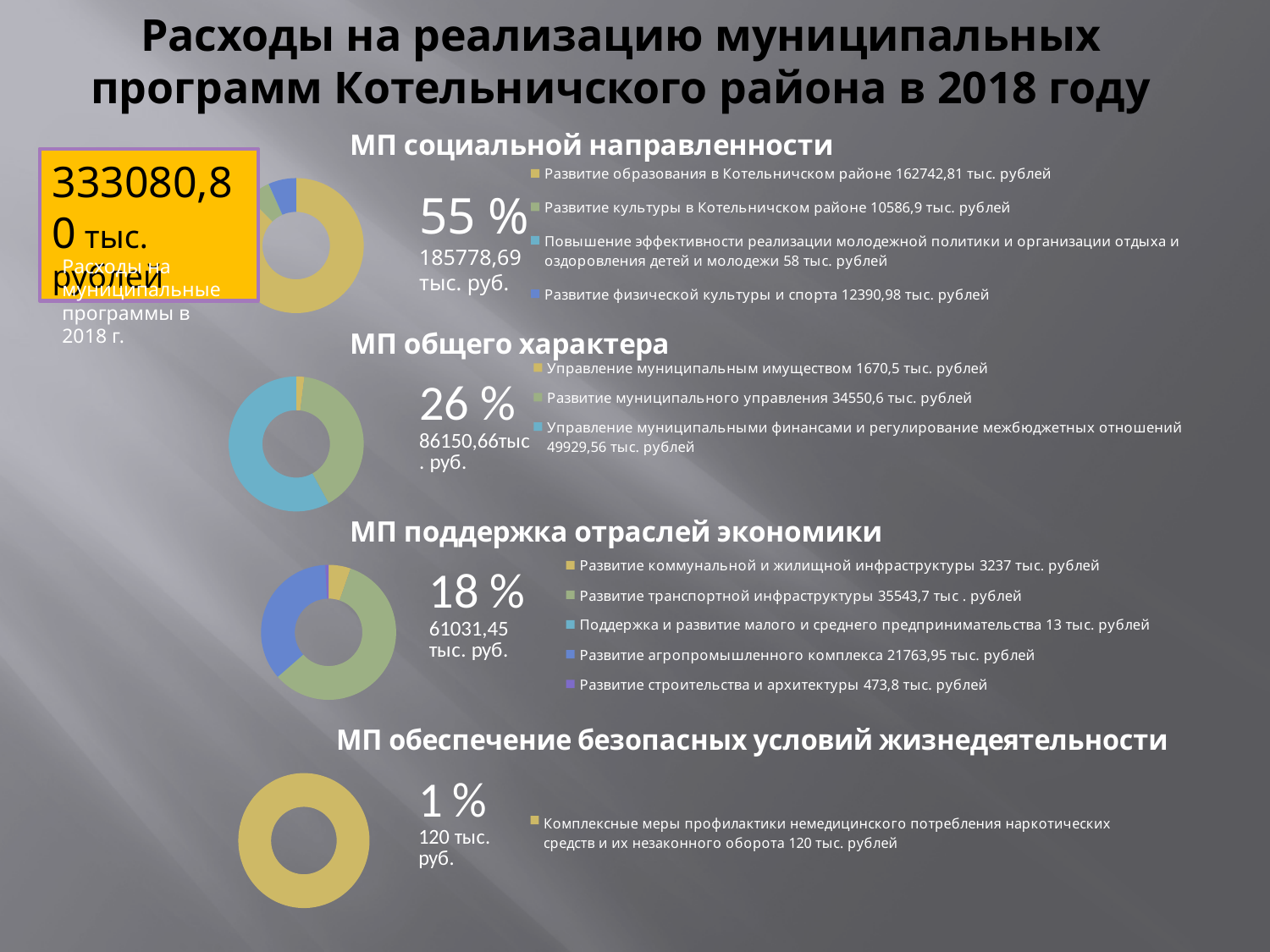
What kind of chart is used for "МП обеспечение безопасных условий жизнедеятельности"? Doughnut chart What percentage is shown next to the chart titled "МП поддержка отраслей экономики"? 18 % How many categories does the legend of the chart titled "МП социальной направленности" list? 4 On the chart titled "МП социальной направленности", which category has the smallest value? Повышение эффективности реализации молодежной политики и организации отдыха и оздоровления детей и молодежи On the chart titled "МП социальной направленности", what is the value for "Развитие образования в Котельничском районе"? 162742,81 тыс. рублей On the chart titled "МП общего характера", what is the value for "Развитие муниципального управления"? 34550,6 тыс. рублей On the chart titled "МП обеспечение безопасных условий жизнедеятельности", what is the value for "Комплексные меры профилактики немедицинского потребления наркотических средств и их незаконного оборота"? 120 тыс. рублей On the chart titled "МП поддержка отраслей экономики", which is larger: "Развитие коммунальной и жилищной инфраструктуры" or "Развитие строительства и архитектуры"? Развитие коммунальной и жилищной инфраструктуры On the chart titled "МП общего характера", what is the difference between "Управление муниципальными финансами и регулирование межбюджетных отношений" and "Развитие муниципального управления"? 15378,96 тыс. рублей On the chart titled "МП общего характера", which category has the largest value? Управление муниципальными финансами и регулирование межбюджетных отношений On the chart titled "МП поддержка отраслей экономики", what is the value for "Развитие агропромышленного комплекса"? 21763,95 тыс. рублей How many categories does the legend of the chart titled "МП поддержка отраслей экономики" list? 5